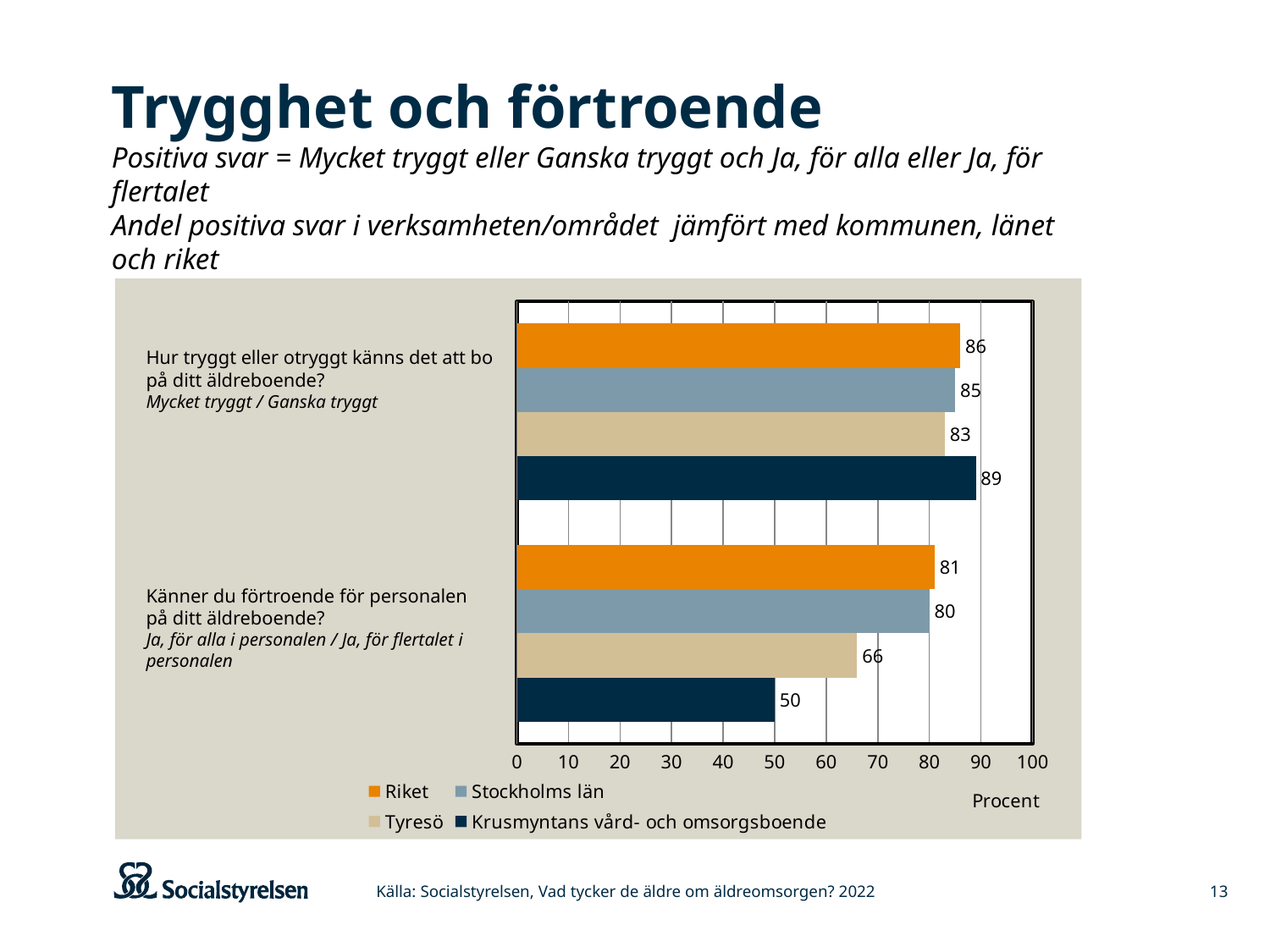
What kind of chart is shown on the slide? Bar chart What is the difference between the Riket value and the Krusmyntans vård- och omsorgsboende value on the question "Känner du förtroende för personalen på ditt äldreboende?"? 31 How many question categories are shown on the chart? 2 What is the value for Tyresö on the question "Känner du förtroende för personalen på ditt äldreboende?"? 66 What is the value for Riket on the question "Känner du förtroende för personalen på ditt äldreboende?"? 81 Which series has the highest value on the question "Hur tryggt eller otryggt känns det att bo på ditt äldreboende?"? Krusmyntans vård- och omsorgsboende What is the value for Stockholms län on the question "Hur tryggt eller otryggt känns det att bo på ditt äldreboende?"? 85 Which series has the lowest value on the question "Känner du förtroende för personalen på ditt äldreboende?"? Krusmyntans vård- och omsorgsboende What is the value for Krusmyntans vård- och omsorgsboende on the question "Hur tryggt eller otryggt känns det att bo på ditt äldreboende?"? 89 On the question "Hur tryggt eller otryggt känns det att bo på ditt äldreboende?", which is larger: the value for Tyresö or the value for Krusmyntans vård- och omsorgsboende? Krusmyntans vård- och omsorgsboende How many series does the legend list? 4 What unit label is shown below the x axis of the chart? Procent